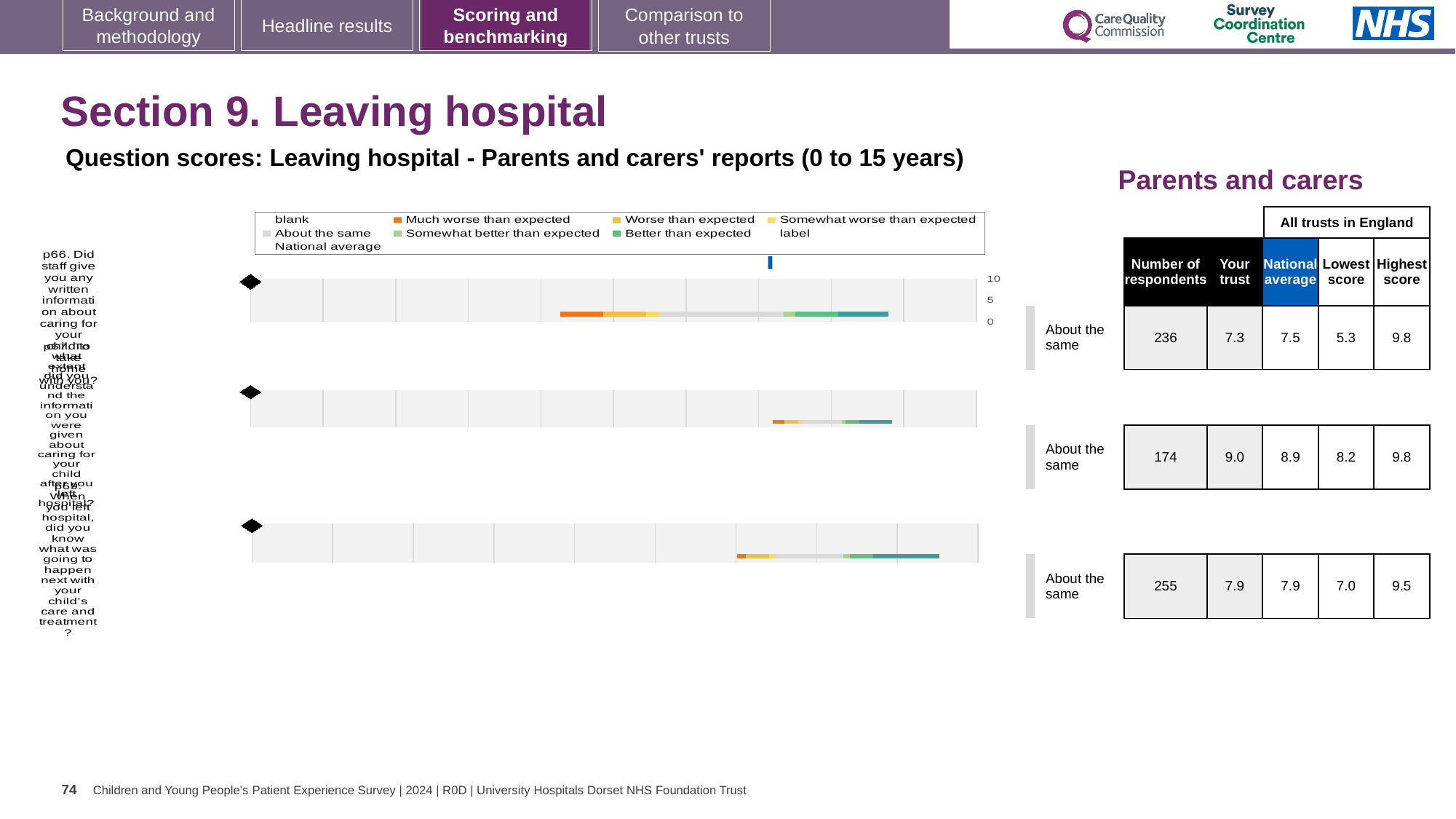
In the legend, which category is shown in dark teal/green? Better than expected How many separate benchmarking charts (one per question) are shown on the slide? 3 In the legend, which category is shown in orange? Much worse than expected Which of the three questions has the lowest 'Lowest score' value in the table beside the charts? p66 (top chart), 5.3 In the table beside the charts, what is the number of respondents for the bottom chart (p68, knowing what would happen next)? 255 How many entries does the shared legend above the charts list? 9 For the bottom chart (p68), is the 'Your trust' score larger than, smaller than, or equal to the national average? equal (7.9) In the table beside the charts, what is the national average for the middle chart (p67, understanding the information given)? 8.9 In the table beside the charts, what is the 'Your trust' score for the top chart (p66, written information about caring for your child at home)? 7.3 Which of the three questions has the highest 'Your trust' score in the table beside the charts? p67 (middle chart), 9.0 What is the difference between the 'Your trust' scores for the middle chart (9.0) and the top chart (7.3)? 1.7 What kind of chart is used to show the benchmarking results for each question on this slide? bar chart